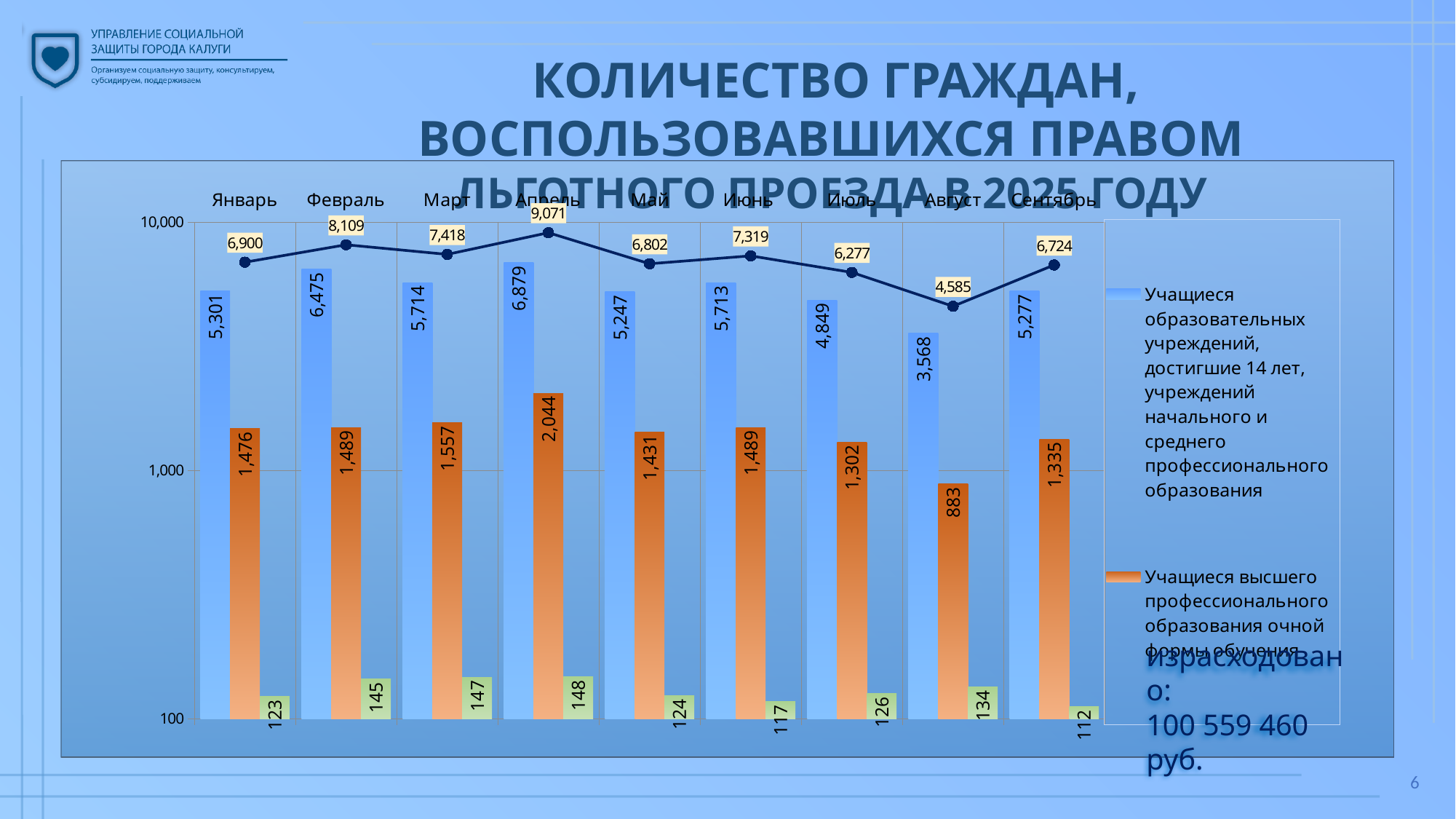
How many months are shown on the x axis? 9 Does the line value rise or fall from Июль to Август? Fall What value does the line show for Февраль? 8,109 Is the orange bar value for Август greater or less than 1,000? less In which month is the blue bar (Учащиеся образовательных учреждений) lowest? Август What is the difference between the orange bar values for Апрель and Март? 487 What is the value of the green bar for Сентябрь? 112 In which month does the line reach its highest value? Апрель What is the value of the orange bar (Учащиеся высшего профессионального образования) for Август? 883 Which is larger: the blue bar for Февраль or the blue bar for Март? Февраль What is the value of the blue bar (Учащиеся образовательных учреждений) for Апрель? 6,879 What kind of chart is shown on the slide? Bar chart with a line